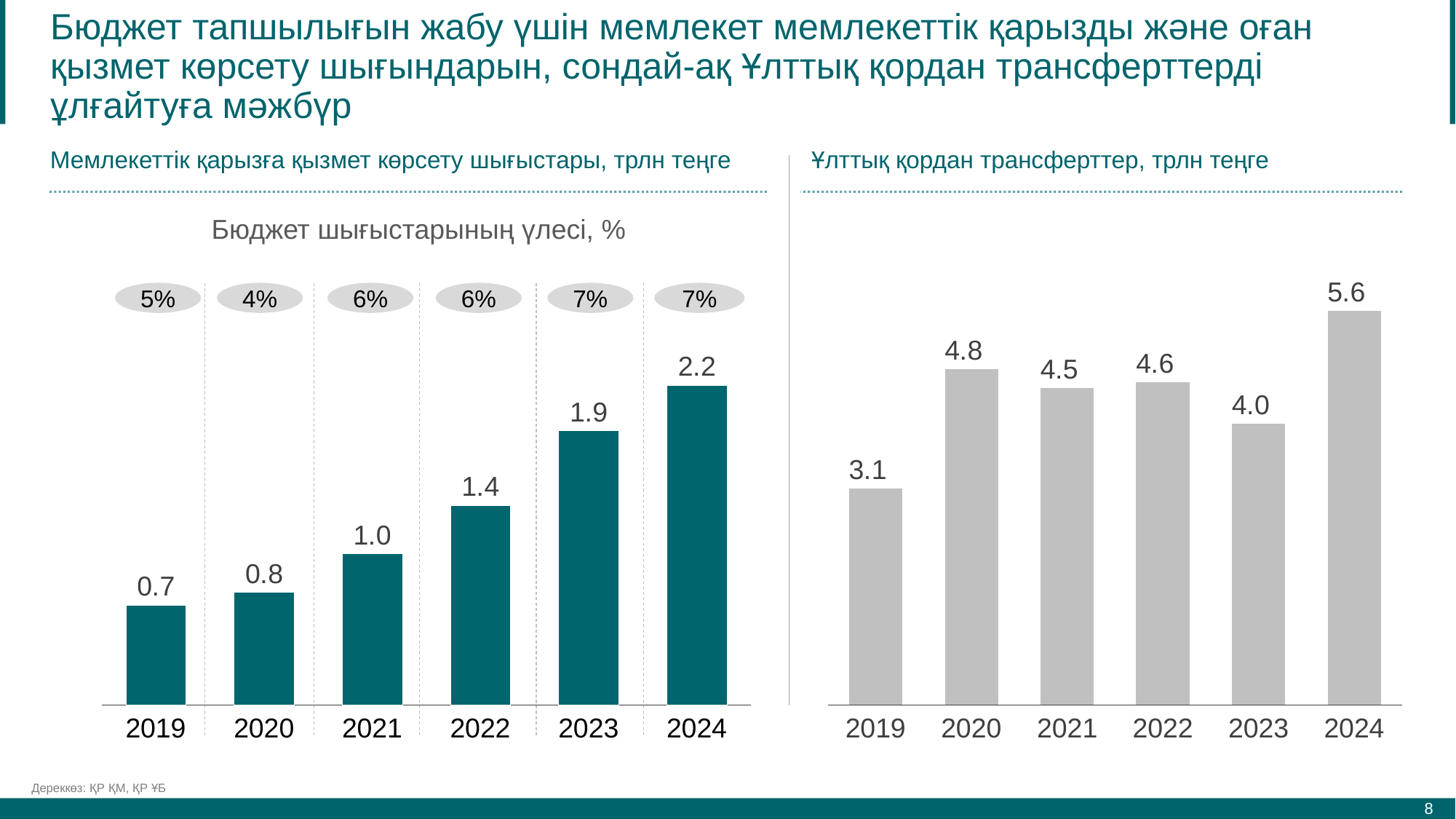
What is the title of the right chart? Ұлттық қордан трансферттер, трлн теңге In the right chart (Ұлттық қордан трансферттер, трлн теңге), what is the value for 2021? 4.5 In the right chart, what is the difference between the values for 2024 and 2023? 1.6 How many years are shown on the x axis of the left chart? 6 In the left chart, what is the difference between the values for 2024 and 2019? 1.5 In the right chart, which year has the lowest value? 2019 In the right chart, which is larger: the value for 2020 or the value for 2022? 2020 In the left chart (Мемлекеттік қарызға қызмет көрсету шығыстары, трлн теңге), what is the value for 2022? 1.4 In the left chart, do the values rise or fall from 2019 to 2024? rise In the left chart, which year has the highest value? 2024 In the left chart, what share of budget expenditures (Бюджет шығыстарының үлесі, %) is shown for 2020? 4% What kind of chart is the right chart? bar chart